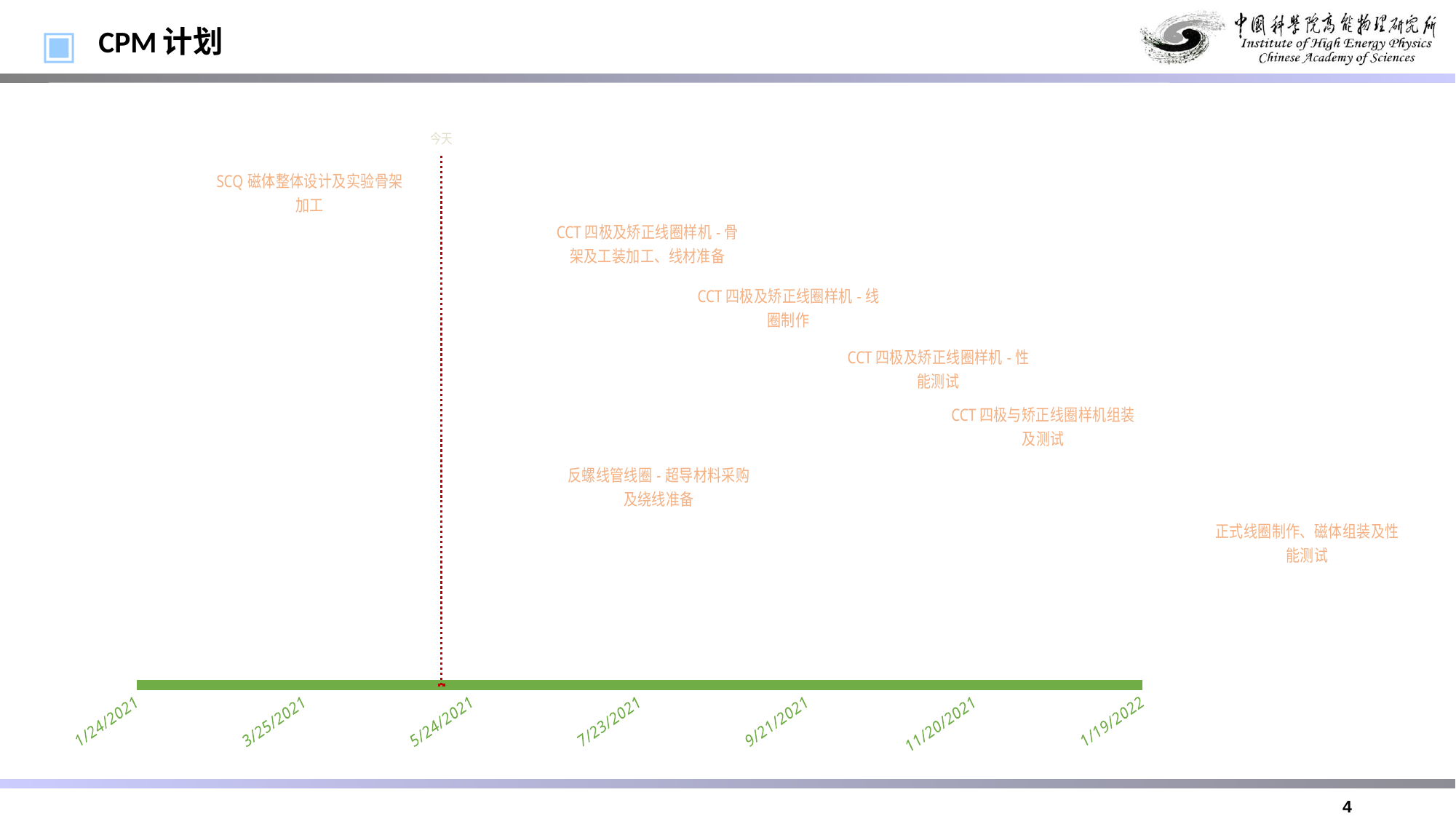
What kind of chart is shown on the slide? Timeline Which date tick comes immediately after 7/23/2021 on the axis? 9/21/2021 Which task label is positioned furthest to the right (latest) on the timeline? 正式线圈制作、磁体组装及性能测试 How many date ticks are labelled along the green time axis? 7 What is the title of the slide containing the timeline? CPM 计划 What colour is the time axis line at the bottom of the chart? Green Which task label is positioned furthest to the left (earliest) on the timeline? SCQ 磁体整体设计及实验骨架加工 How many task labels are shown above the time axis? 7 What is the first date labelled on the time axis? 1/24/2021 What is the last date labelled on the time axis? 1/19/2022 On which axis date does the dotted '今天' (today) marker fall? 5/24/2021